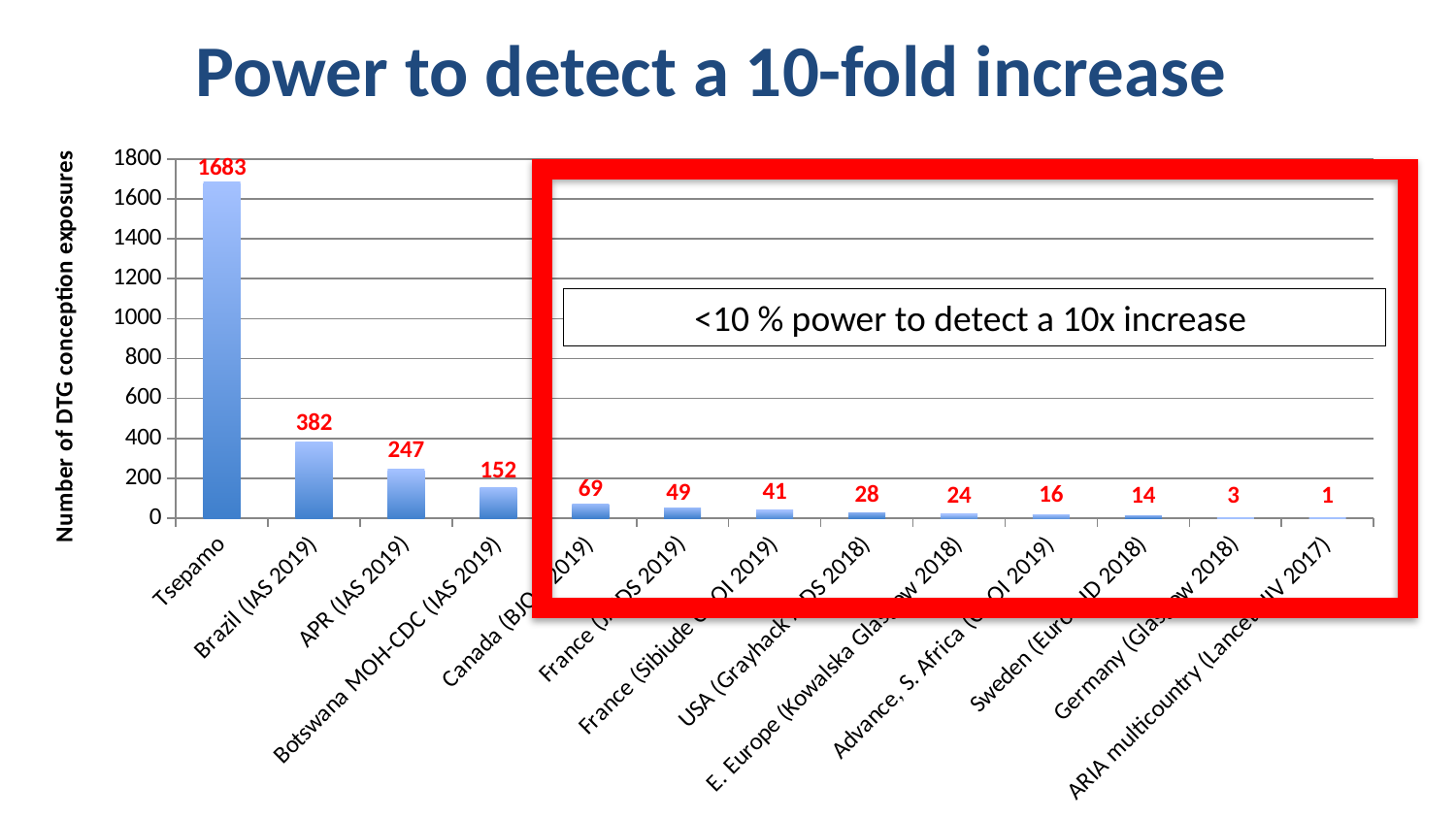
What is the value shown for Botswana MOH-CDC (IAS 2019)? 152 What is the value shown for E. Europe (Kowalska Glasgow 2018)? 24 What type of chart is shown on the slide? Bar chart What is the number of DTG conception exposures for Tsepamo? 1683 What is the value shown for Brazil (IAS 2019)? 382 How many categories (bars) are shown in the chart? 13 Which category has the highest number of DTG conception exposures? Tsepamo What is the value shown for APR (IAS 2019)? 247 Which is larger, the value for APR (IAS 2019) or the value for Botswana MOH-CDC (IAS 2019)? APR (IAS 2019) What is the difference between the values for Tsepamo and Brazil (IAS 2019)? 1301 Which category has the lowest number of DTG conception exposures? ARIA multicountry What is the value shown for Germany (Glasgow 2018)? 3